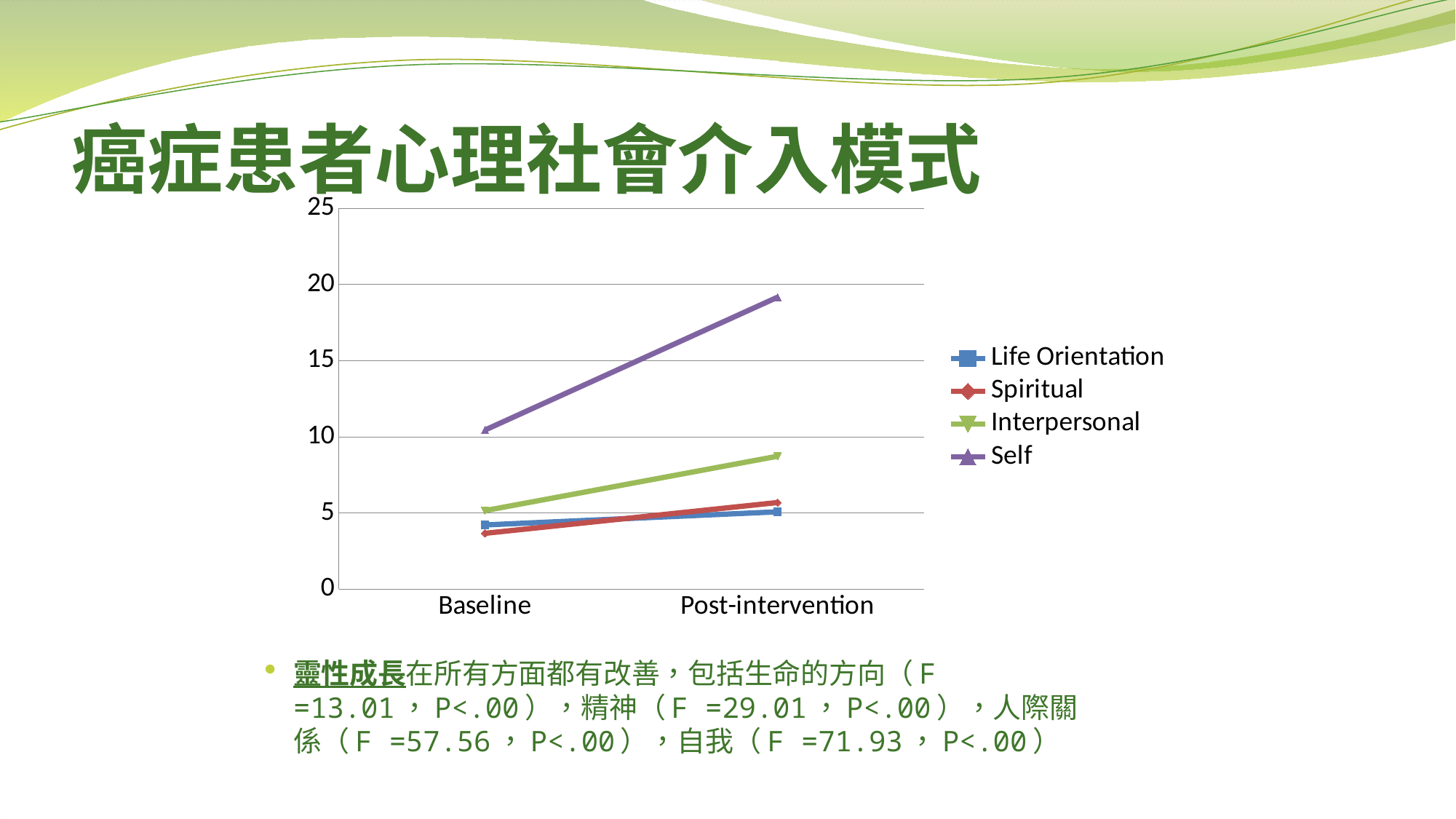
Is the value for Interpersonal at Baseline greater or less than 10? less How many categories are shown on the x axis of the chart? 2 Does the Self series rise or fall from Baseline to Post-intervention? rise What colour is the line for the Self series? purple Which series has the lowest value at Baseline? Spiritual What kind of chart is shown on the slide? line chart Which series has the highest value at Post-intervention? Self At Post-intervention, which is larger: the value for Self or the value for Interpersonal? Self Is the value for Spiritual at Baseline greater or less than 5? less Is the value for Self at Post-intervention greater or less than 15? greater How many series does the chart legend list? 4